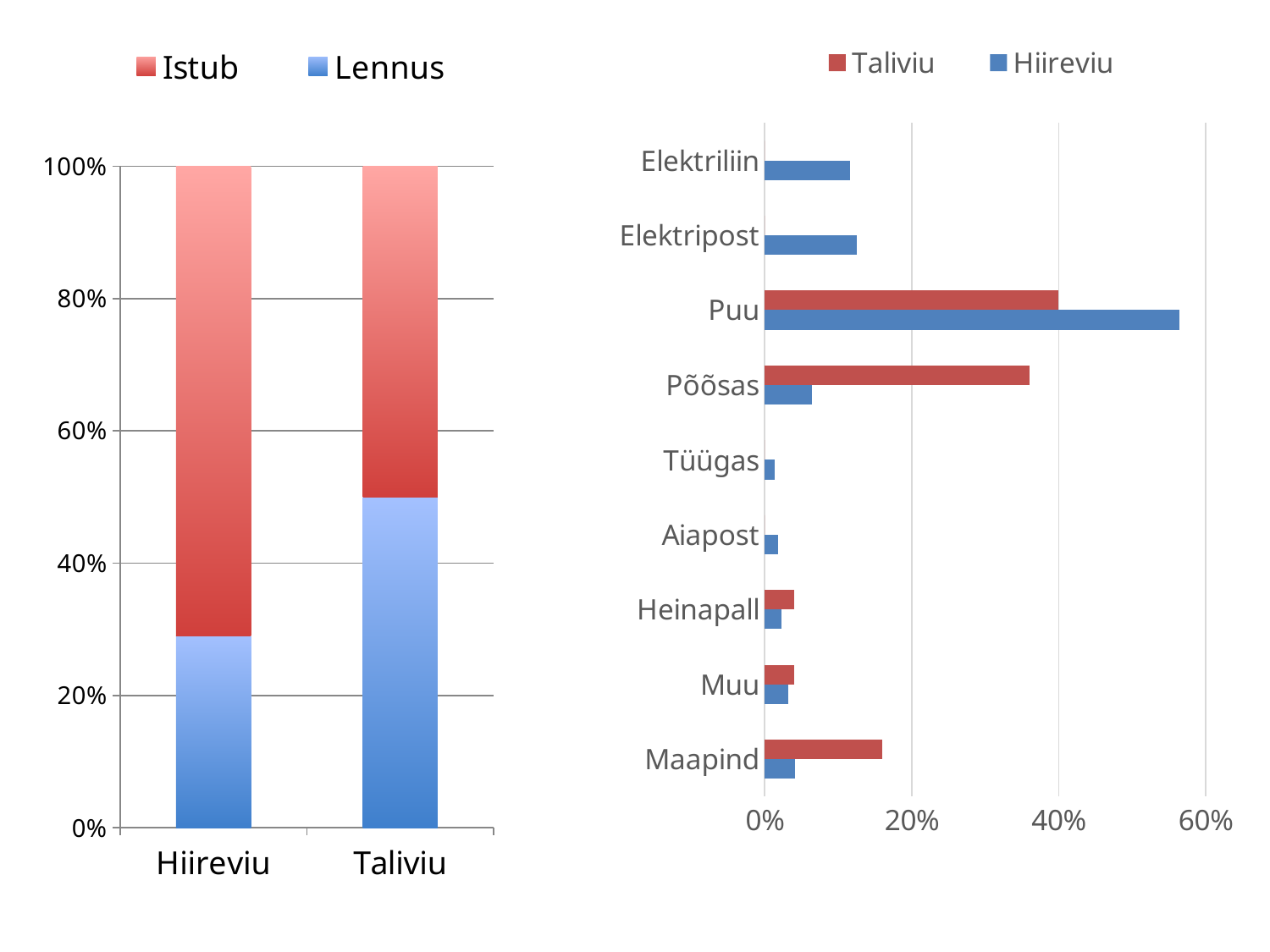
What kind of chart is the chart on the left of the slide? bar chart What kind of chart is the chart on the right of the slide? bar chart How many series does the legend of the left chart list? 2 In the right chart, which category has the highest Hiireviu value? Puu In the left chart, which category has the larger Lennus share, Hiireviu or Taliviu? Taliviu In the right chart, is the Hiireviu value for Puu greater or less than 40%? greater How many categories are listed on the vertical axis of the right chart? 9 In the right chart, which series is larger for Maapind, Taliviu or Hiireviu? Taliviu How many categories are shown on the x axis of the left chart? 2 In the left chart, is the Istub value for Hiireviu greater or less than 60%? greater In the right chart, is the Taliviu value for Põõsas greater or less than 20%? greater